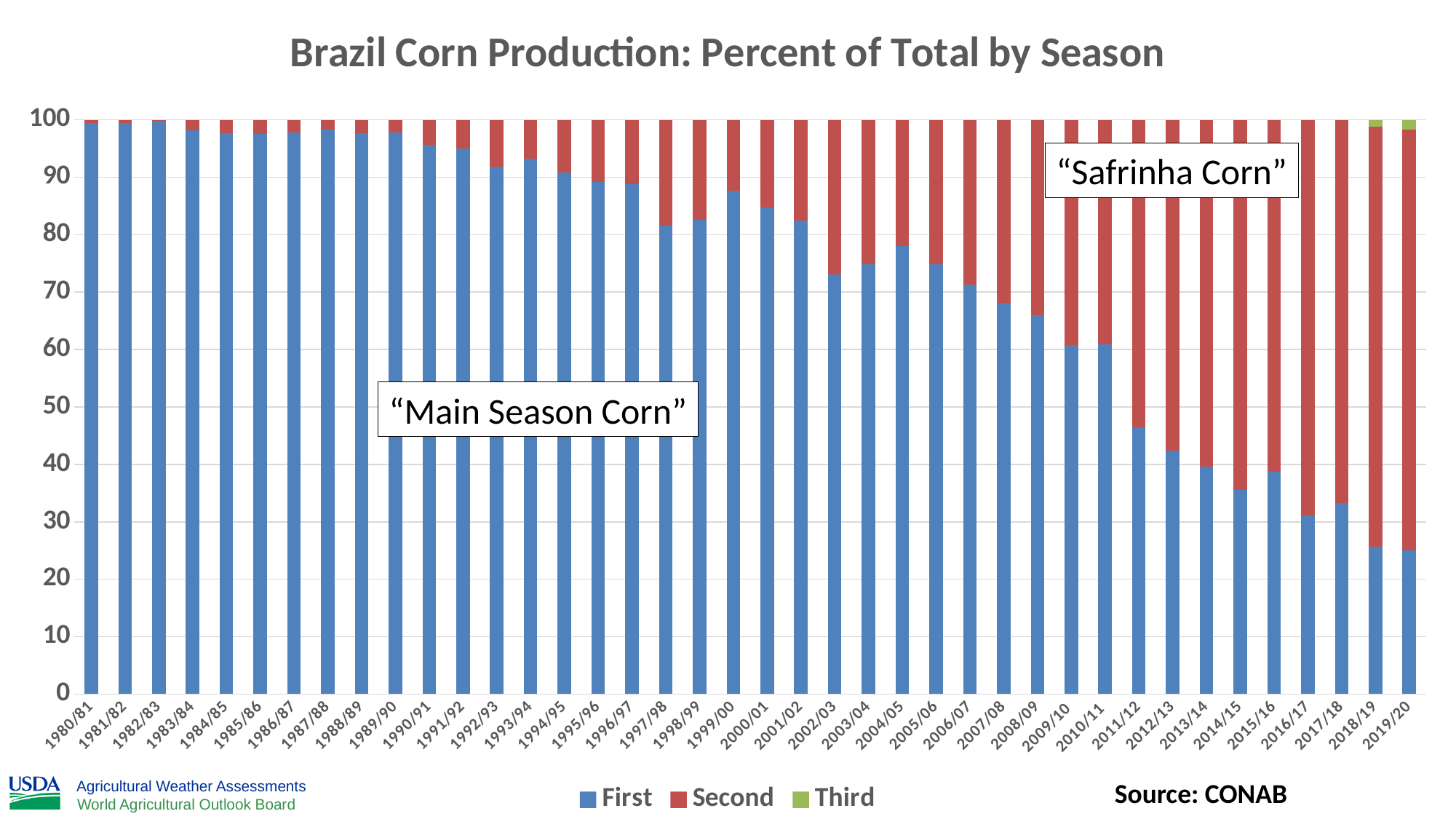
Is the value for the First series in 2019/20 greater or less than 30? less Which is larger, the First series value for 2000/01 or for 2005/06? 2000/01 Does the share of the First season rise or fall from 1980/81 to 2019/20? fall What kind of chart is shown on the slide? stacked bar chart Which series is labelled with the annotation "Safrinha Corn"? Second Is the value for the First series in 2010/11 greater or less than 50? greater How many seasons (categories) are plotted along the x axis? 40 How many series does the legend list? 3 Which is larger, the Second series value for 2017/18 or for 1990/91? 2017/18 What is the title of the chart? Brazil Corn Production: Percent of Total by Season Is the value for the First series in 1980/81 greater or less than 90? greater